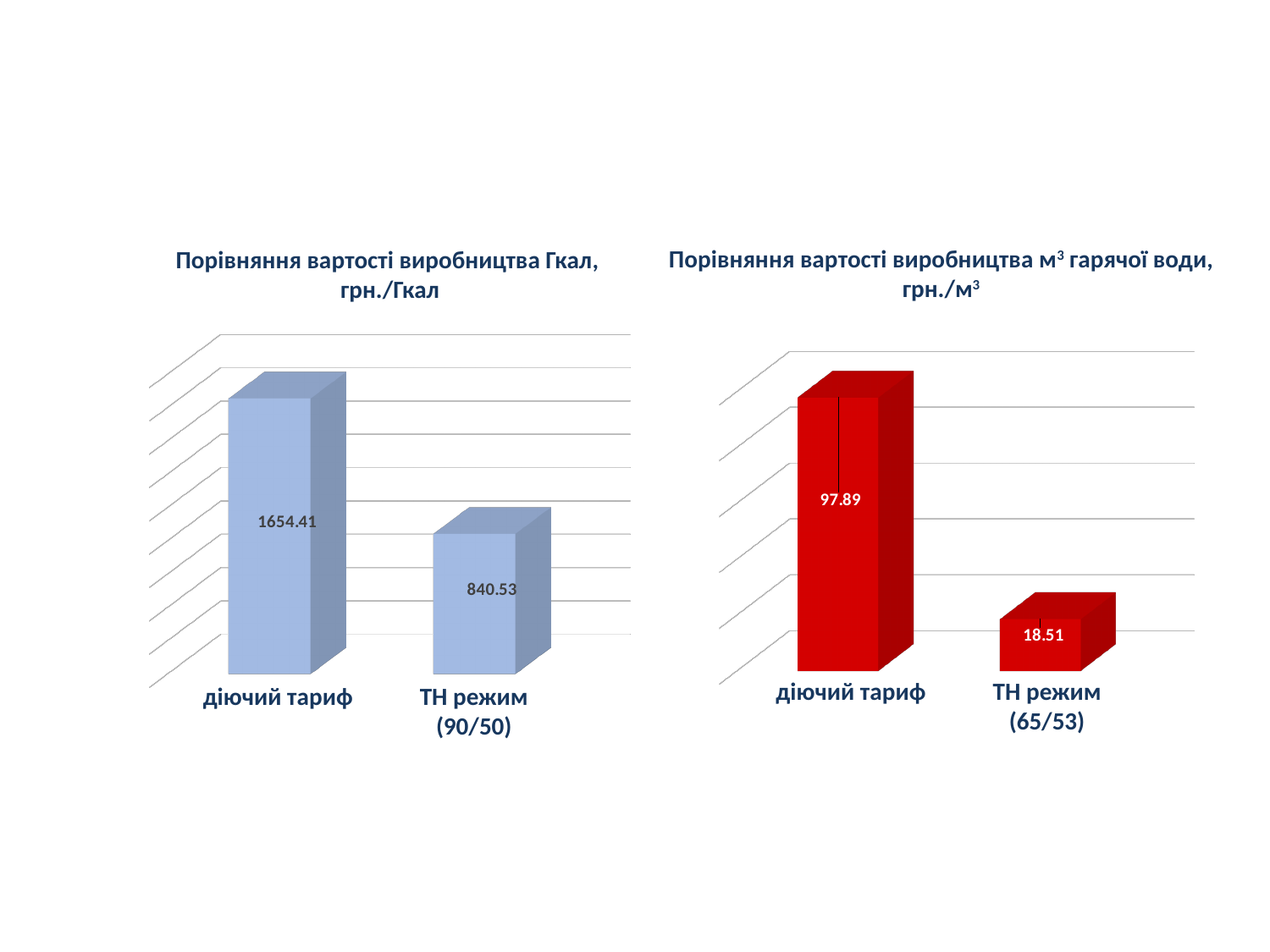
What colour are the bars in the right chart? red In the right chart, which is larger: the value for діючий тариф or for ТН режим (65/53)? діючий тариф In the left chart, what is the difference between the values for діючий тариф and ТН режим (90/50)? 813.88 What type of chart is the right chart? bar chart In the left chart (Порівняння вартості виробництва Гкал, грн./Гкал), what is the value for діючий тариф? 1654.41 In the right chart, which category has the lowest value? ТН режим (65/53) In the right chart, what is the difference between the values for діючий тариф and ТН режим (65/53)? 79.38 In the left chart (Порівняння вартості виробництва Гкал, грн./Гкал), what is the value for ТН режим (90/50)? 840.53 How many categories are shown in the left chart? 2 In the left chart, which category has the highest value? діючий тариф In the right chart (Порівняння вартості виробництва м³ гарячої води, грн./м³), what is the value for ТН режим (65/53)? 18.51 In the right chart (Порівняння вартості виробництва м³ гарячої води, грн./м³), what is the value for діючий тариф? 97.89